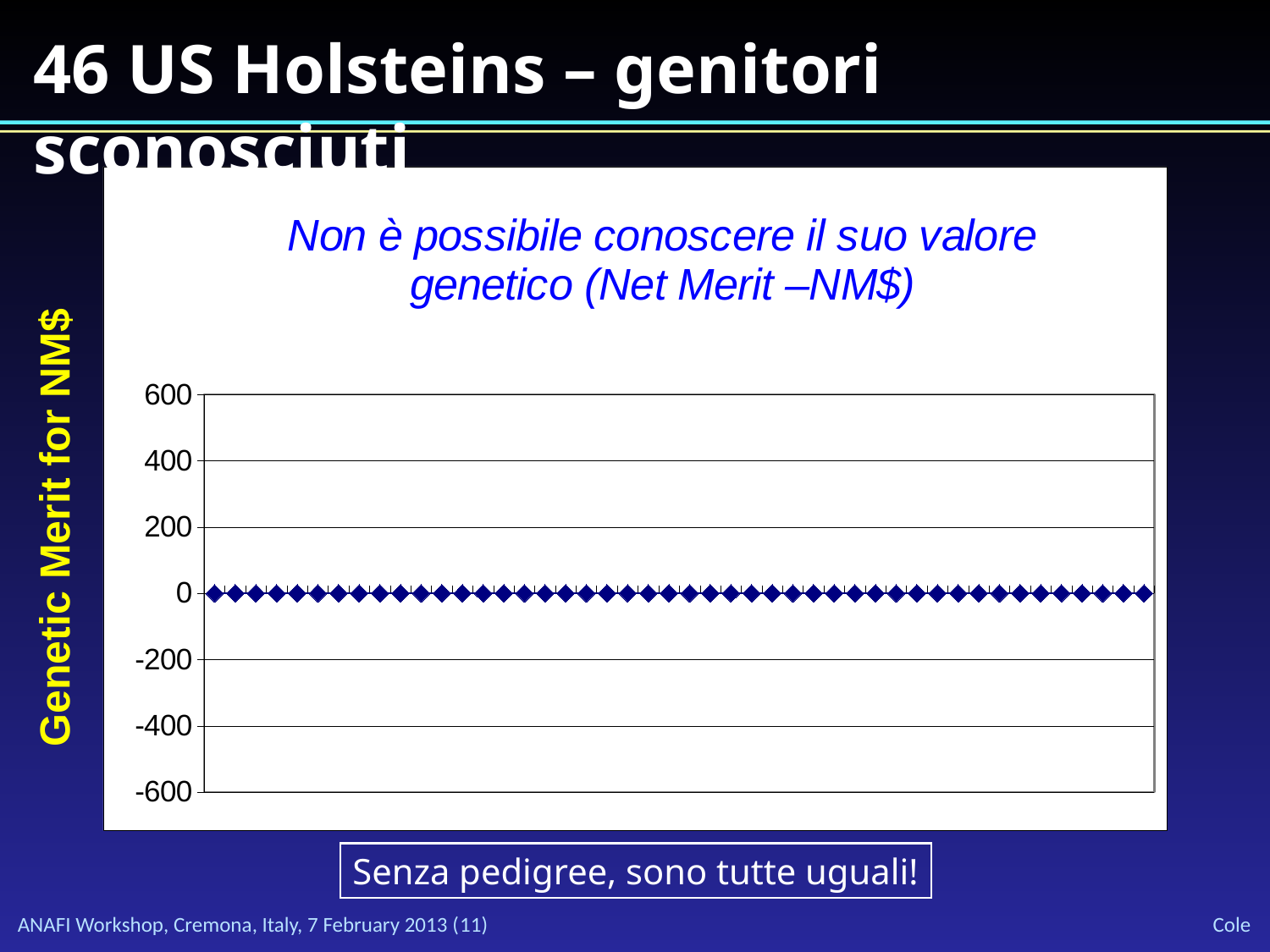
How many tick labels are shown on the y axis? 7 What is the highest value shown on the y axis? 600 What value do all the plotted points share on the y axis? 0 What is the lowest value shown on the y axis? -600 What colour are the plotted markers? dark blue How many animals (points) does the chart represent, according to the slide title? 46 Do the plotted values rise, fall, or stay flat along the x axis? stay flat Are the plotted values greater or less than -200? greater What is the label of the y axis? Genetic Merit for NM$ Are the plotted values greater or less than 200? less What is the interval between consecutive y-axis tick labels? 200